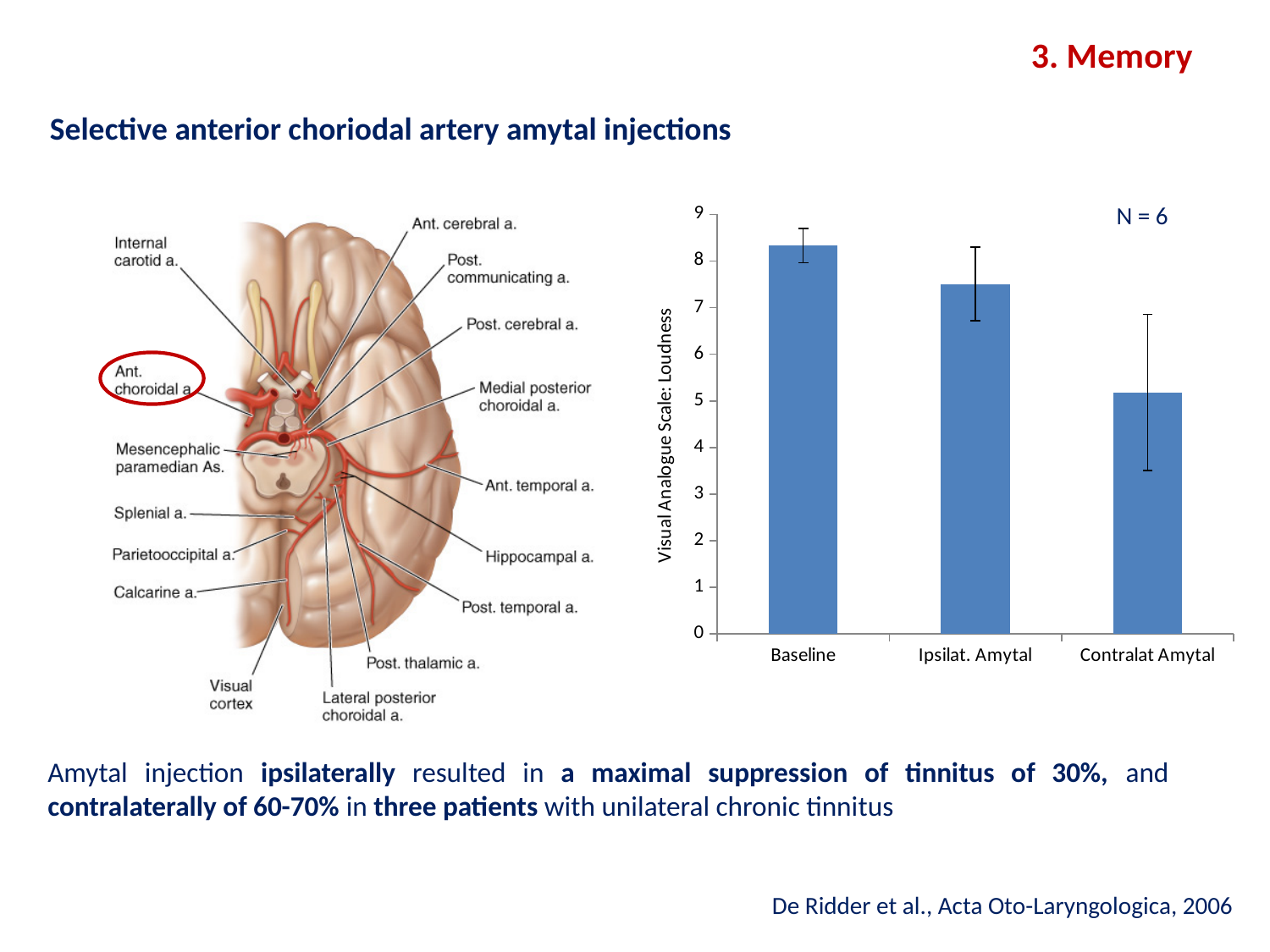
How many categories are plotted on the x axis of the bar chart? 3 What kind of chart is shown on the slide? bar chart Which category has the highest bar in the chart? Baseline What sample size (N) is noted on the chart? N = 6 Which bar is taller, Baseline or Ipsilat. Amytal? Baseline Is the value for Contralat Amytal greater or less than 6? less Is the value for Baseline greater or less than 8? greater What is the label of the y axis of the bar chart? Visual Analogue Scale: Loudness Is the value for Ipsilat. Amytal greater or less than 7? greater Do the bar values rise or fall from Baseline to Contralat Amytal along the x axis? fall Which bar is taller, Ipsilat. Amytal or Contralat Amytal? Ipsilat. Amytal Which category has the lowest bar in the chart? Contralat Amytal